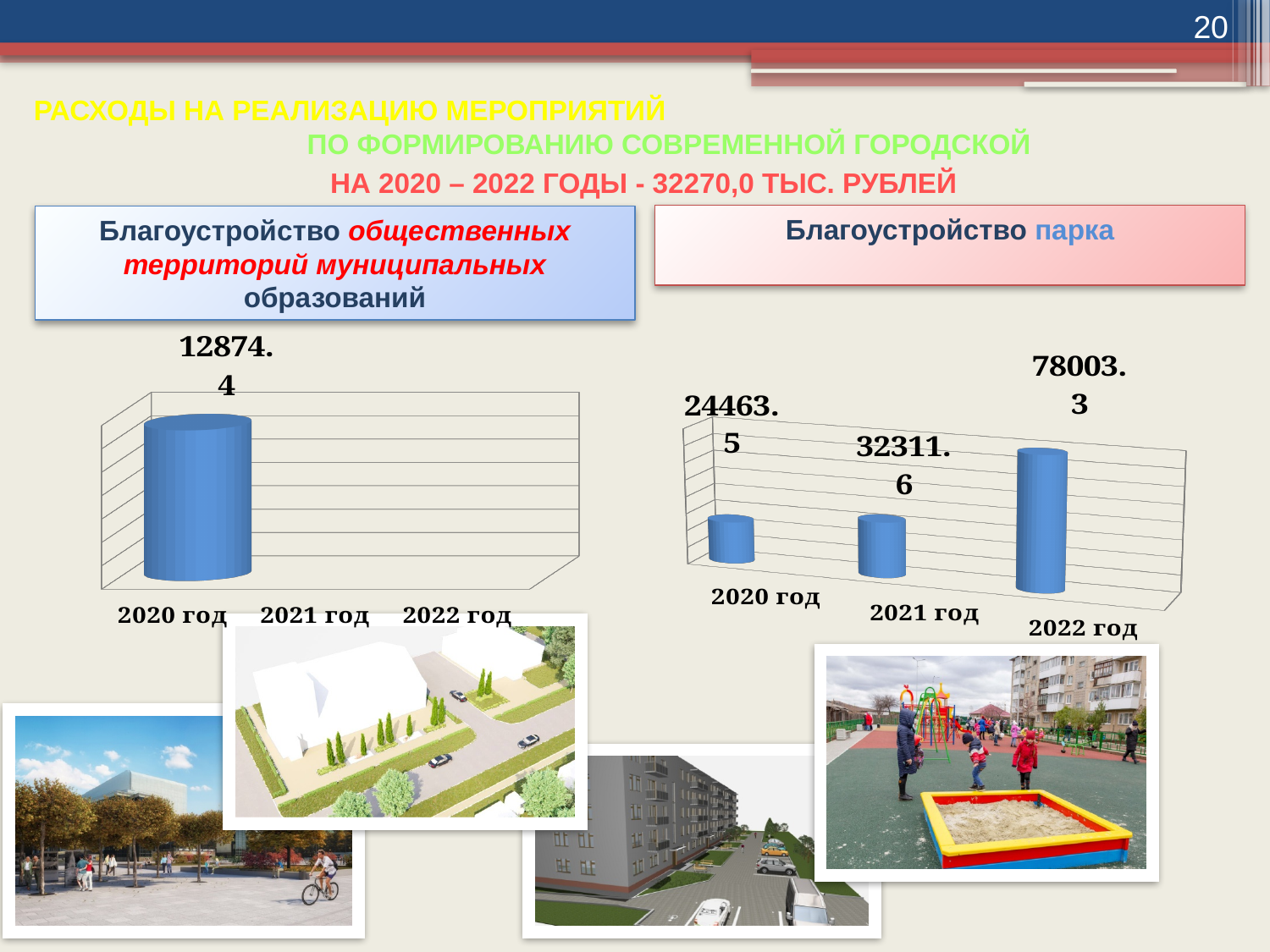
In the left chart (Благоустройство общественных территорий муниципальных образований), what is the value for 2020 год? 12874.4 In the right chart (Благоустройство парка), what is the value for 2021 год? 32311.6 In the right chart (Благоустройство парка), what is the difference between the values for 2022 год and 2021 год? 45691.7 What kind of chart is the right chart (Благоустройство парка)? bar chart In the right chart (Благоустройство парка), which is larger: the value for 2021 год or the value for 2020 год? 2021 год In the right chart (Благоустройство парка), what is the difference between the values for 2021 год and 2020 год? 7848.1 In the right chart (Благоустройство парка), which year has the highest value? 2022 год In the right chart (Благоустройство парка), what is the value for 2022 год? 78003.3 How many year categories are shown on the x axis of the left chart (Благоустройство общественных территорий муниципальных образований)? 3 In the right chart (Благоустройство парка), what is the value for 2020 год? 24463.5 In the right chart (Благоустройство парка), which year has the lowest value? 2020 год In the right chart (Благоустройство парка), do the values rise or fall from 2020 год to 2022 год? rise